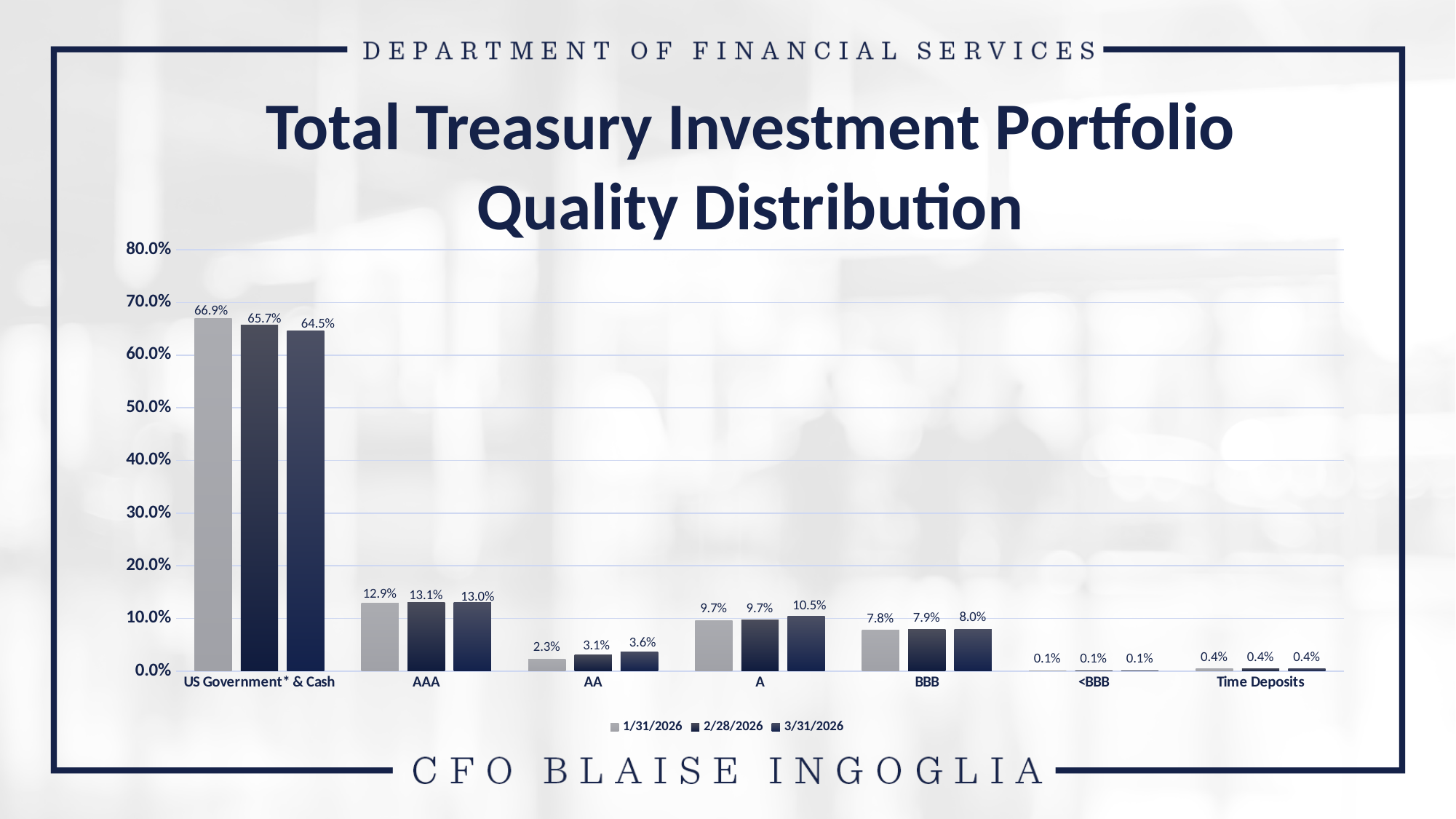
What is the difference between the US Government* & Cash values on 1/31/2026 and 3/31/2026? 2.4% What is the value for US Government* & Cash on 1/31/2026? 66.9% Which category has the highest value on 3/31/2026? US Government* & Cash What kind of chart is shown on the slide? Bar chart What is the value for AAA on 3/31/2026? 13.0% What is the value for AA on 2/28/2026? 3.1% Which category has the lowest value on 1/31/2026? <BBB What is the value for A on 3/31/2026? 10.5% Which is larger for BBB: the 2/28/2026 value or the 3/31/2026 value? 3/31/2026 How many series does the legend list? 3 How many categories are shown on the x axis? 7 Is the value for US Government* & Cash on 2/28/2026 greater or less than 60.0%? greater